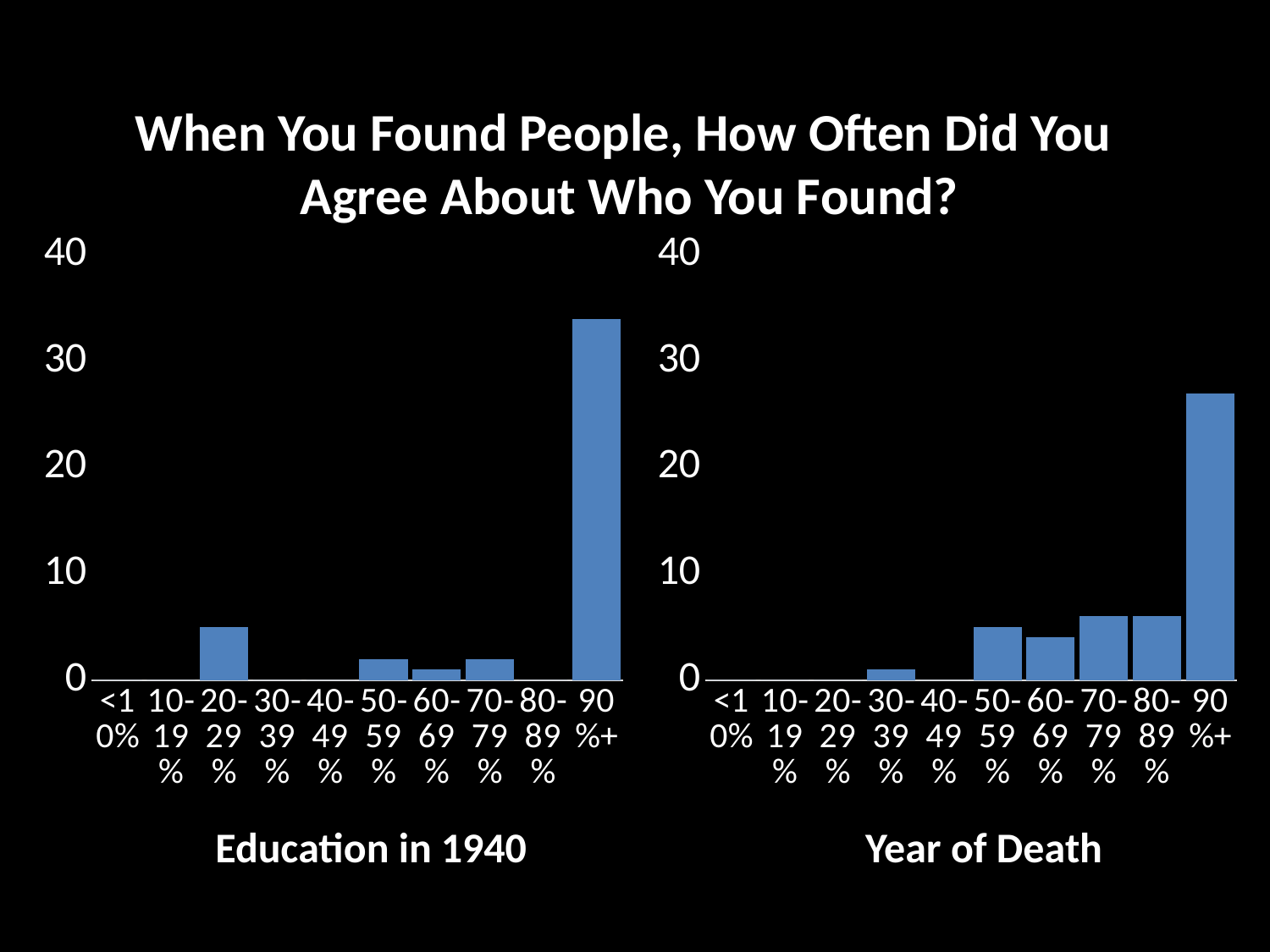
In the "Year of Death" chart, which category has the highest bar? 90%+ What kind of chart is the "Education in 1940" chart? bar chart In the "Education in 1940" chart, is the value for 20-29% greater or less than 10? less In the "Education in 1940" chart, which is larger, the value for 20-29% or the value for 60-69%? 20-29% In the "Year of Death" chart, is the value for 90%+ greater or less than 30? less In the "Year of Death" chart, is the value for 90%+ greater or less than 20? greater Which chart has the taller 90%+ bar, "Education in 1940" or "Year of Death"? Education in 1940 In the "Education in 1940" chart, which category has the highest bar? 90%+ How many categories are shown on the x axis of the "Year of Death" chart? 10 What is the title shown above the two charts on the slide? When You Found People, How Often Did You Agree About Who You Found? In the "Year of Death" chart, which is larger, the value for 70-79% or the value for 30-39%? 70-79%